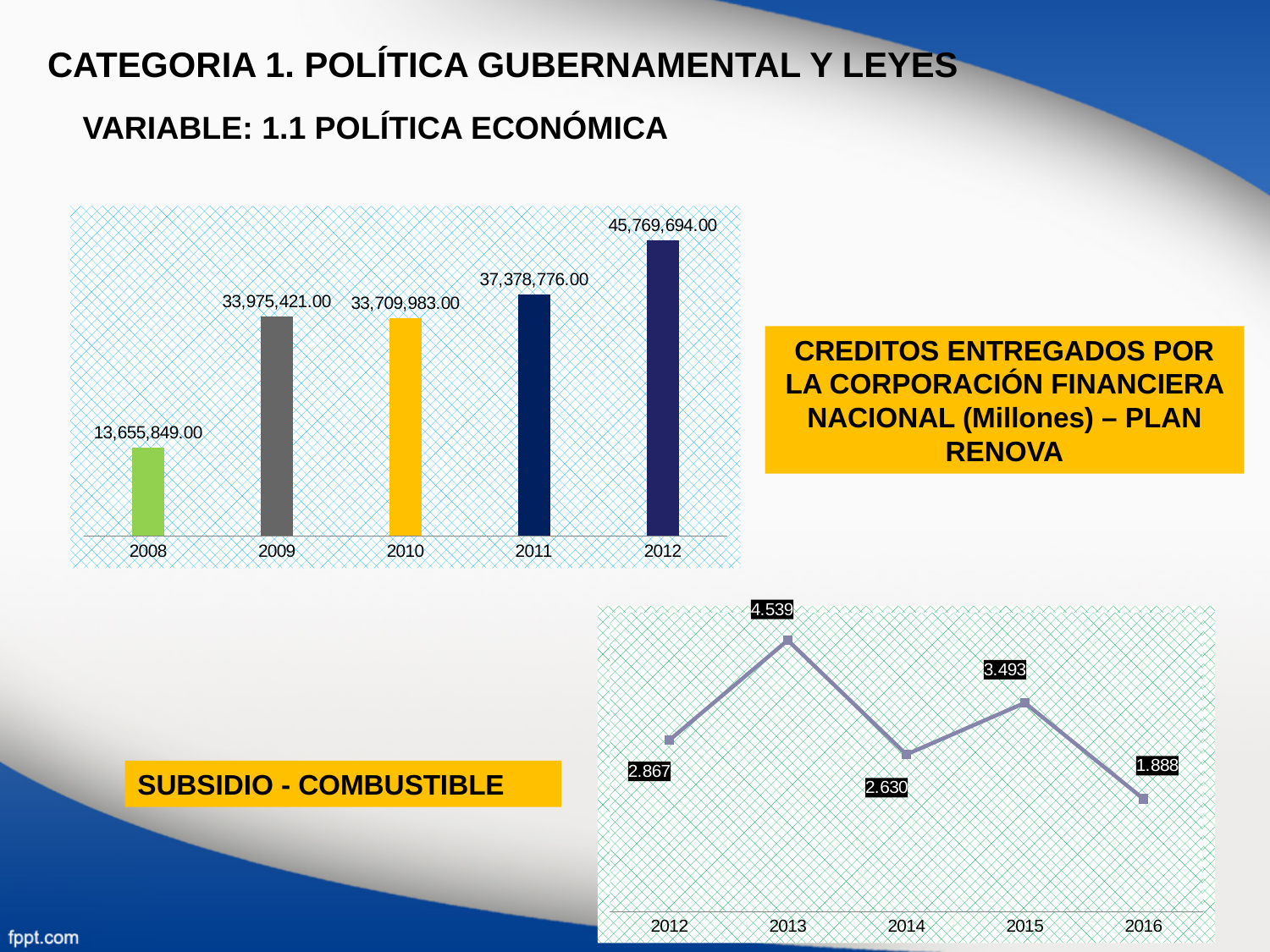
In the bar chart titled 'CREDITOS ENTREGADOS POR LA CORPORACIÓN FINANCIERA NACIONAL (Millones) – PLAN RENOVA', what is the value for 2011? 37,378,776.00 In the bar chart titled 'CREDITOS ENTREGADOS POR LA CORPORACIÓN FINANCIERA NACIONAL (Millones) – PLAN RENOVA', which year has the lowest value? 2008 In the 'SUBSIDIO - COMBUSTIBLE' line chart, what is the difference between the values for 2013 and 2014? 1.909 In the bar chart titled 'CREDITOS ENTREGADOS POR LA CORPORACIÓN FINANCIERA NACIONAL (Millones) – PLAN RENOVA', what is the value for 2008? 13,655,849.00 What kind of chart is the 'SUBSIDIO - COMBUSTIBLE' chart at the bottom right of the slide? Line chart In the bar chart titled 'CREDITOS ENTREGADOS POR LA CORPORACIÓN FINANCIERA NACIONAL (Millones) – PLAN RENOVA', what is the difference between the values for 2012 and 2008? 32,113,845.00 In the bar chart titled 'CREDITOS ENTREGADOS POR LA CORPORACIÓN FINANCIERA NACIONAL (Millones) – PLAN RENOVA', which is larger, the value for 2011 or the value for 2010? 2011 In the 'SUBSIDIO - COMBUSTIBLE' line chart, which year has the lowest value? 2016 In the bar chart titled 'CREDITOS ENTREGADOS POR LA CORPORACIÓN FINANCIERA NACIONAL (Millones) – PLAN RENOVA', which year has the highest value? 2012 In the 'SUBSIDIO - COMBUSTIBLE' line chart, what is the value for 2013? 4.539 How many years are shown in the bar chart titled 'CREDITOS ENTREGADOS POR LA CORPORACIÓN FINANCIERA NACIONAL (Millones) – PLAN RENOVA'? 5 In the 'SUBSIDIO - COMBUSTIBLE' line chart, what is the value for 2016? 1.888